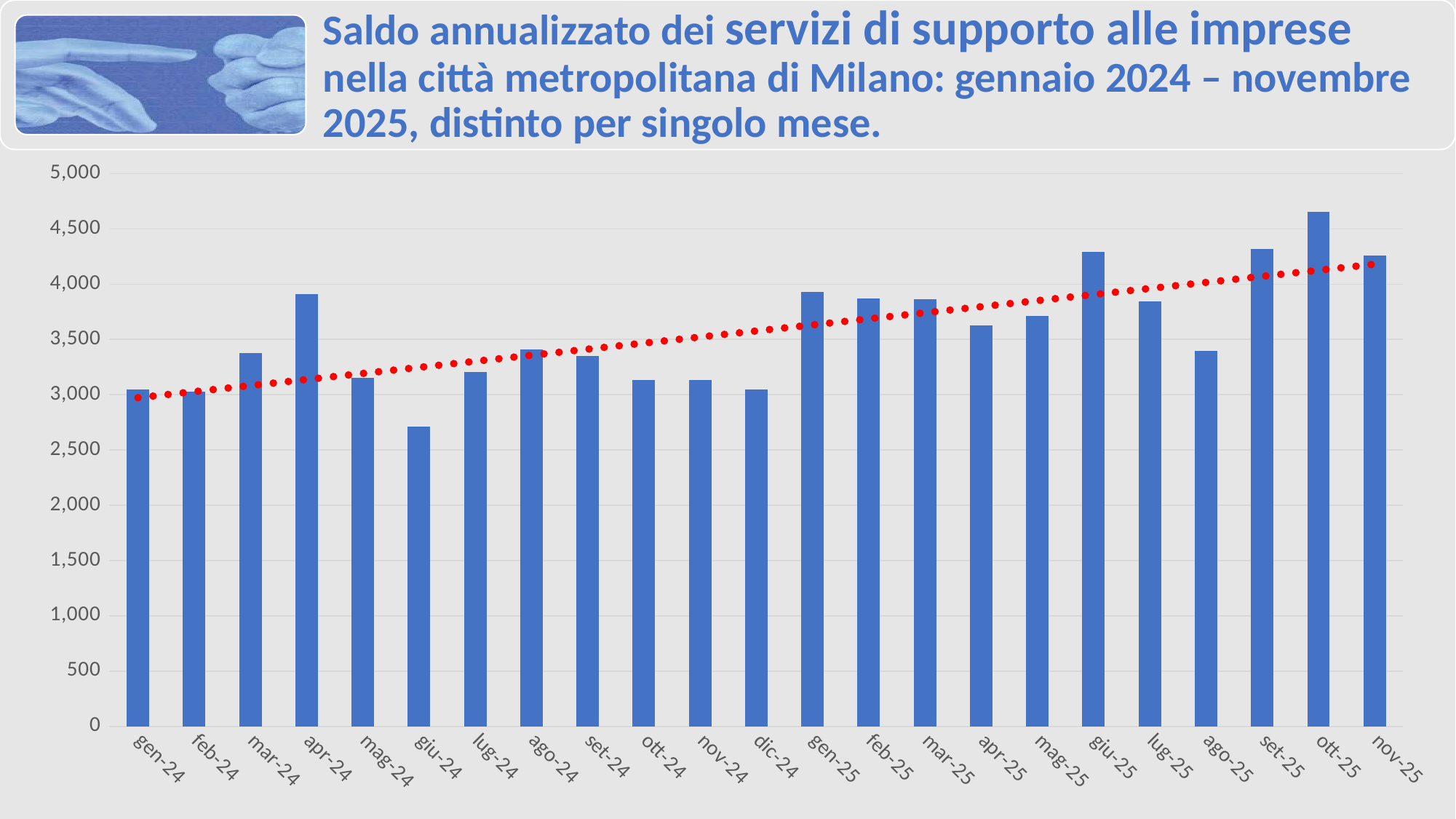
Is the value for ott-25 greater or less than 4,500? greater Which is larger, the value for apr-24 or the value for mag-24? apr-24 What colour are the bars in the chart? blue Is the value for giu-24 greater or less than 3,000? less Is the value for apr-24 greater or less than 3,500? greater How many months are plotted on the x axis? 23 Which month has the lowest bar? giu-24 What kind of chart is shown on the slide? bar chart Which month has the highest bar? ott-25 Does the dotted trend line rise or fall from gen-24 to nov-25? rise Which is larger, the value for giu-25 or the value for lug-25? giu-25